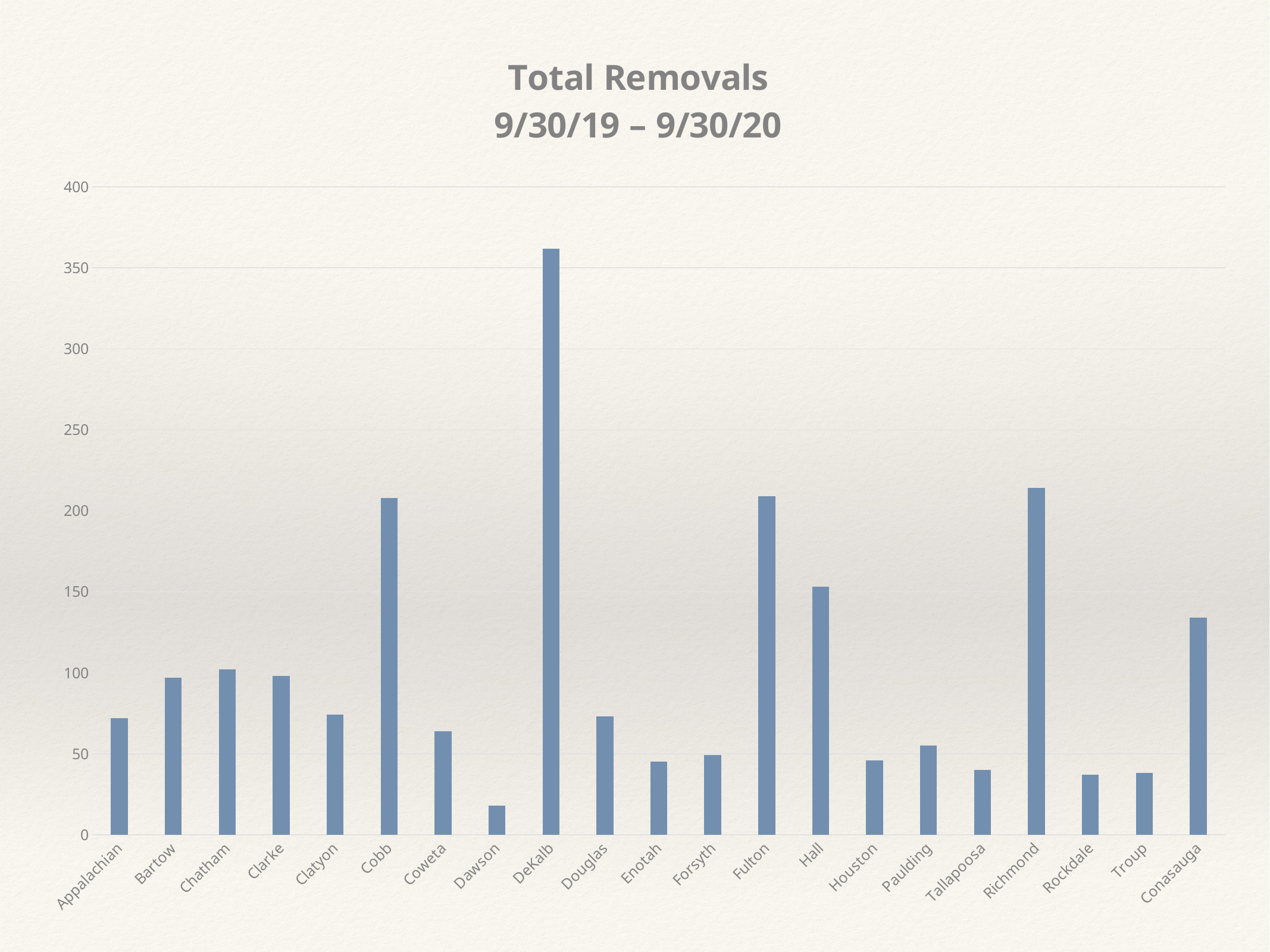
How many categories are plotted on the x axis? 21 Is the value for DeKalb greater or less than 350? greater Is the value for Dawson greater or less than 50? less Is the value for Rockdale greater or less than 50? less Which category has the lowest value? Dawson Which is larger, the value for Cobb or the value for Hall? Cobb Which is larger, the value for Dawson or the value for Troup? Troup What is the title of the chart? Total Removals 9/30/19 – 9/30/20 What kind of chart is shown on the slide? bar chart Which category has the highest value? DeKalb